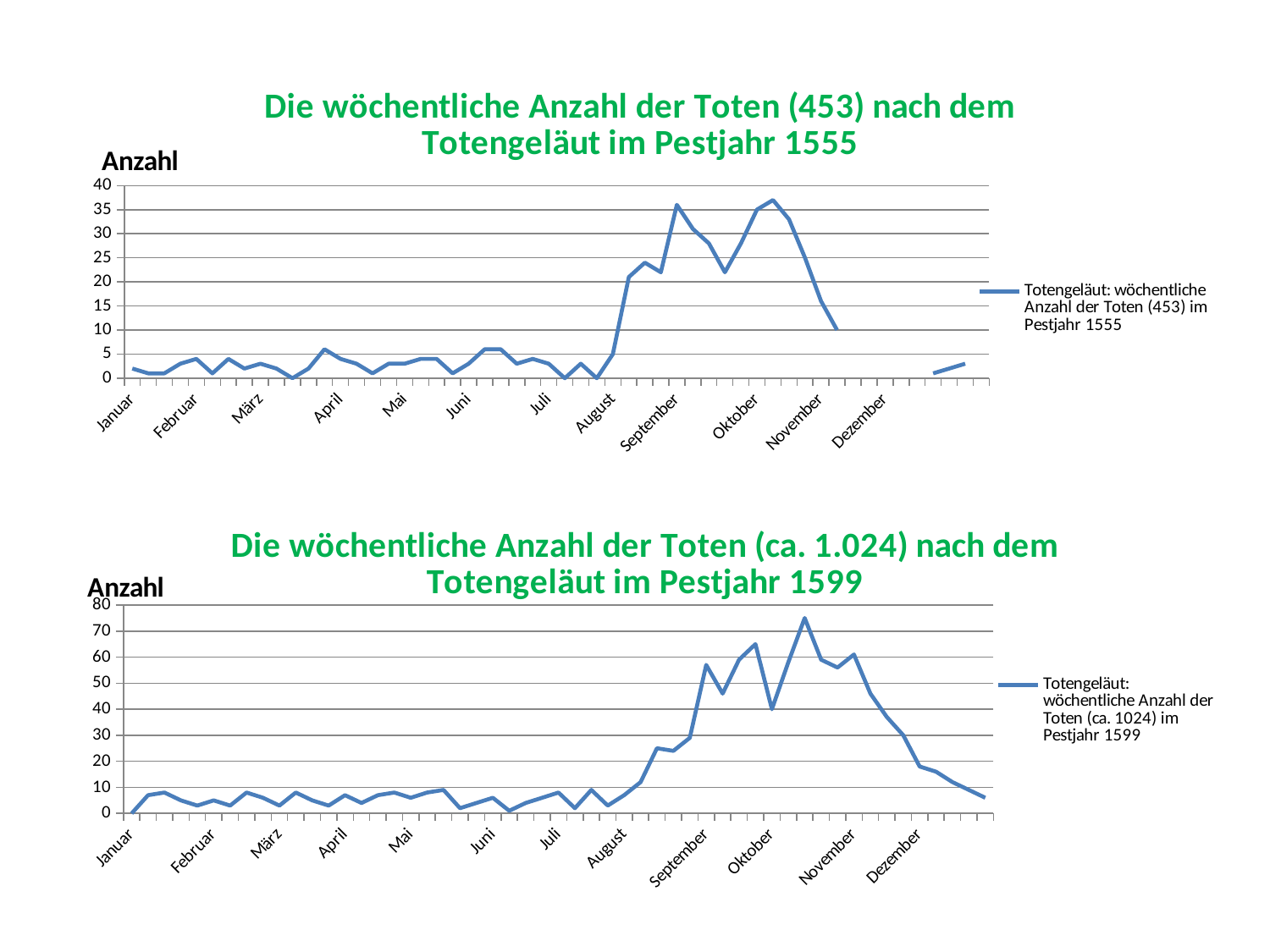
What kind of chart is the top chart, 'Die wöchentliche Anzahl der Toten (453) nach dem Totengeläut im Pestjahr 1555'? line chart In the top chart (Pestjahr 1555), do the weekly values rise or fall from August into September? rise What is the label of the vertical axis on both charts? Anzahl What kind of chart is the bottom chart, 'Die wöchentliche Anzahl der Toten (ca. 1.024) nach dem Totengeläut im Pestjahr 1599'? line chart How many series does the legend of the bottom chart (Pestjahr 1599) list? 1 In the top chart (Pestjahr 1555), are the weekly values in January greater or less than 10? less What is the maximum value shown on the vertical axis of the bottom chart (Pestjahr 1599)? 80 In the bottom chart (Pestjahr 1599), are the weekly values in March greater or less than 20? less In the bottom chart (Pestjahr 1599), do the weekly values rise or fall from November to December? fall In the top chart (Pestjahr 1555), is the highest weekly value, reached in October, greater or less than 35? greater How many series does the legend of the top chart (Pestjahr 1555) list? 1